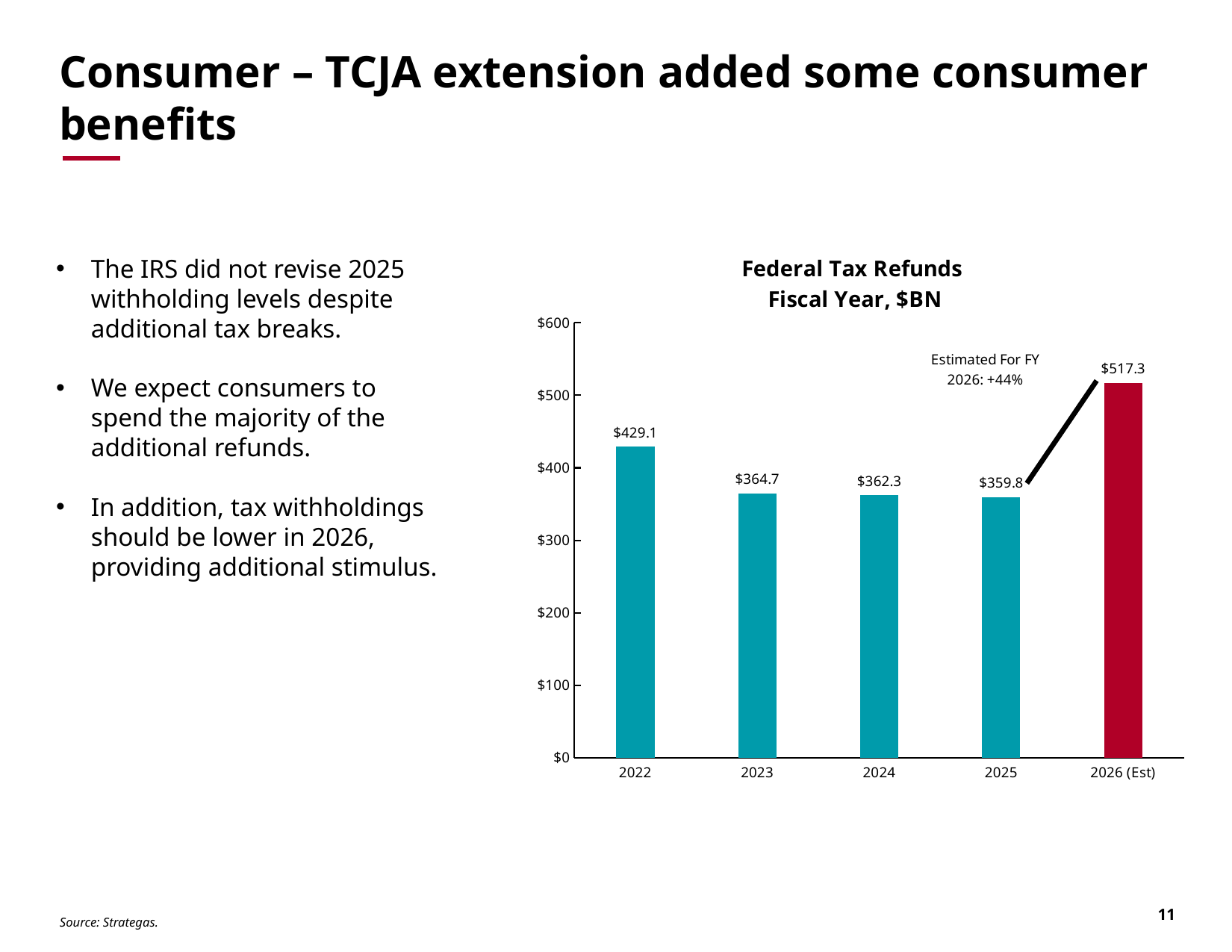
What is the difference between the 2022 value and the 2023 value? $64.4 What is the difference between the 2026 (Est) value and the 2025 value? $157.5 Which fiscal year has the lowest value? 2025 What is the value for 2026 (Est)? $517.3 Which fiscal year has the highest value? 2026 (Est) What is the value for 2022? $429.1 Is the value for 2026 (Est) greater or less than $500? greater What is the value for 2025? $359.8 What is the title of the chart? Federal Tax Refunds Fiscal Year, $BN What kind of chart is shown? Bar chart Which is larger, the value for 2022 or the value for 2024? 2022 How many fiscal years are shown on the x axis? 5